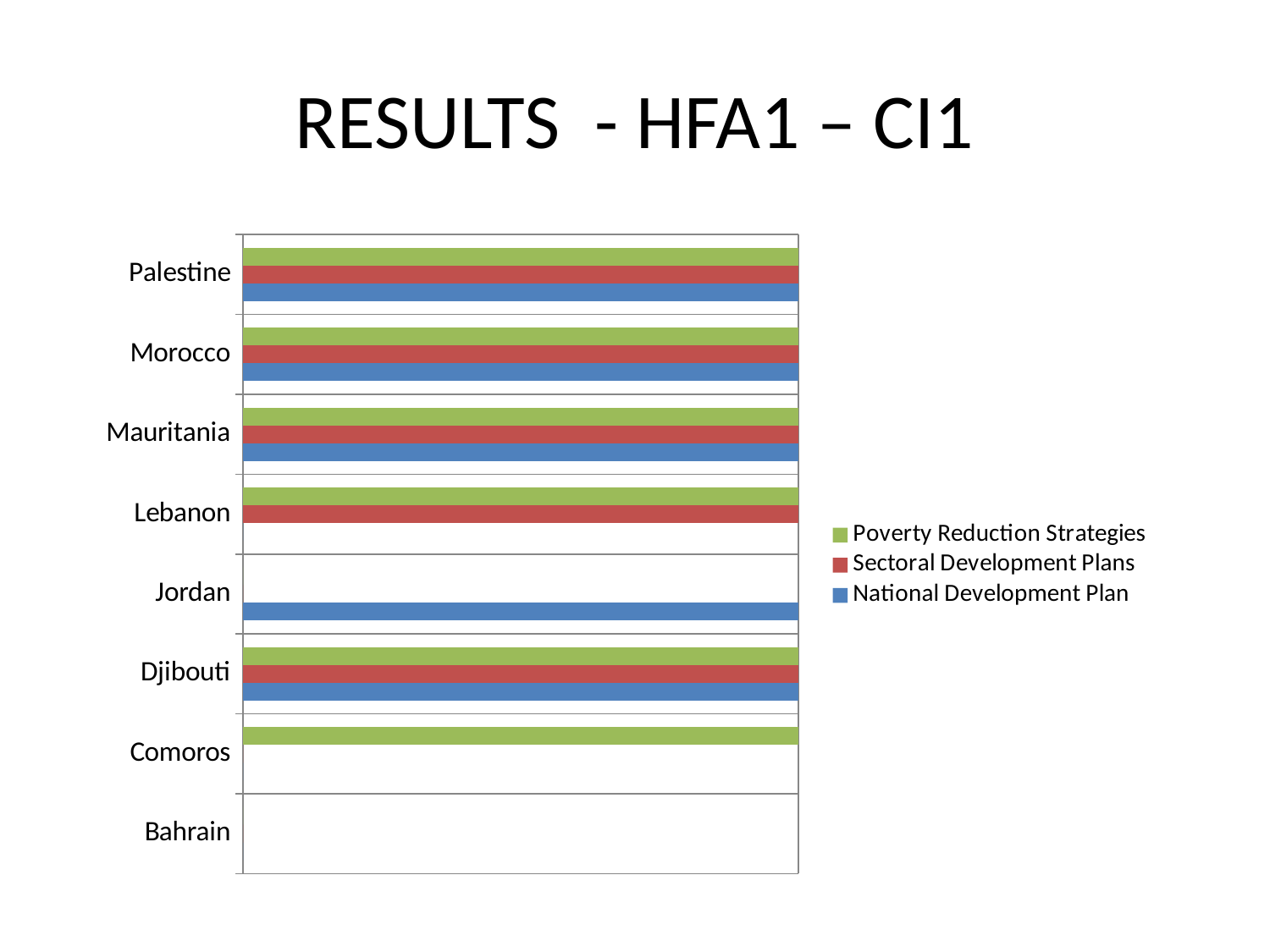
Which is larger, the National Development Plan bar for Jordan or the National Development Plan bar for Lebanon? Jordan Which is the only series with a bar for Jordan? National Development Plan Which series is shown in green in the legend? Poverty Reduction Strategies How many series does the legend list? 3 What is the title of the slide? RESULTS - HFA1 – CI1 Which is the only series with a bar for Comoros? Poverty Reduction Strategies Which country has no bars for any of the three series? Bahrain How many countries are listed on the vertical axis of the chart? 8 Which country is listed at the top of the vertical axis? Palestine Which is larger, the Sectoral Development Plans bar for Djibouti or the Sectoral Development Plans bar for Comoros? Djibouti What kind of chart is shown on the slide? bar chart Which series has no bar for Lebanon? National Development Plan